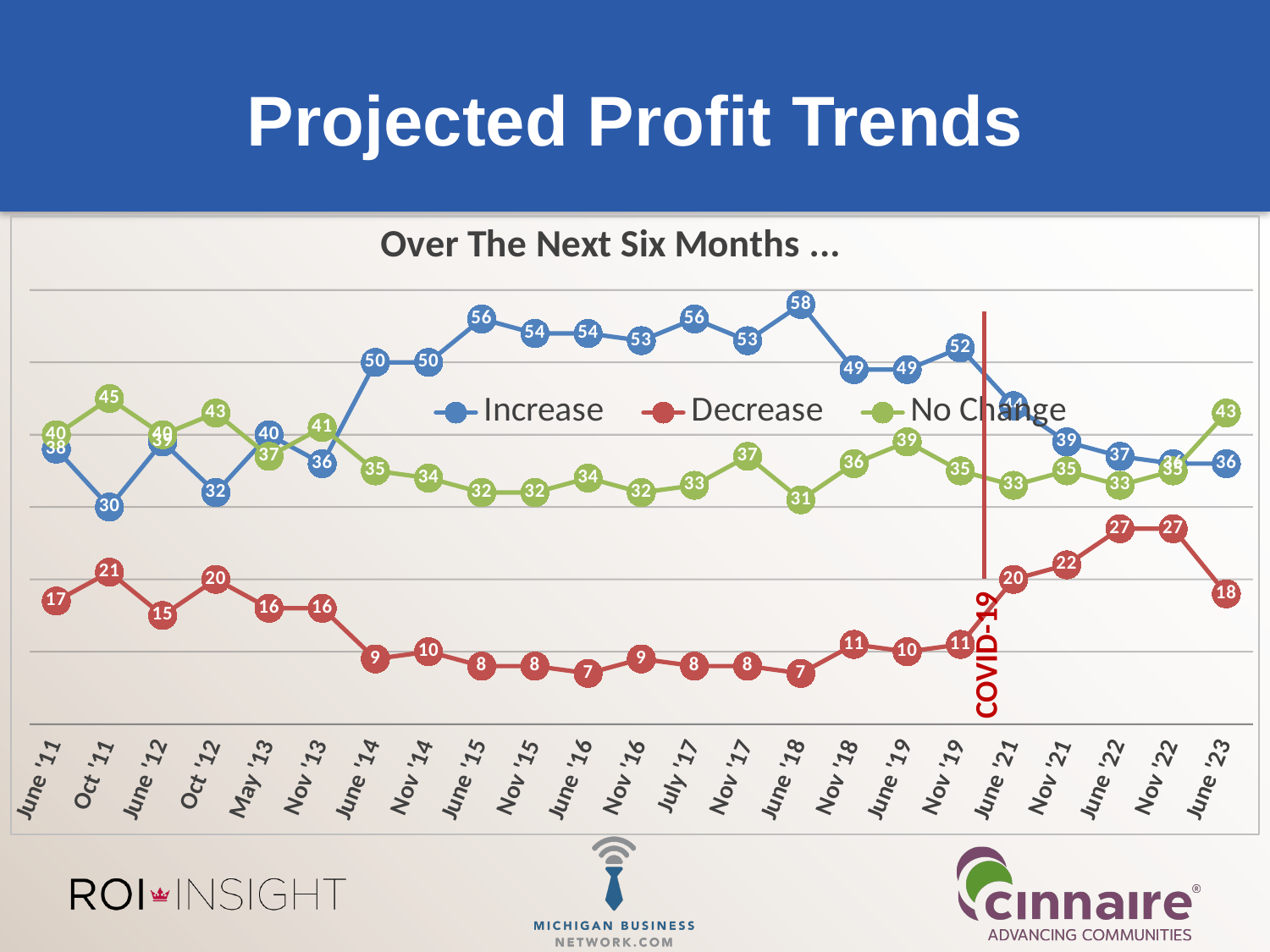
How many series does the legend list? 3 What is the difference between the Increase value and the Decrease value at June '23? 18 At which date is the Increase series at its lowest value? Oct '11 Which is larger for the Decrease series: the value at Nov '22 or the value at June '23? Nov '22 What is the value of the No Change series at June '23? 43 What kind of chart is shown on the slide? line chart What is the value of the Decrease series at June '22? 27 How many dates are shown on the x axis? 23 What is the value of the Increase series at June '18? 58 Does the Decrease series rise or fall from June '21 to June '22? rise What is the title shown above the chart? Over The Next Six Months ... At which date does the Increase series reach its highest value? June '18